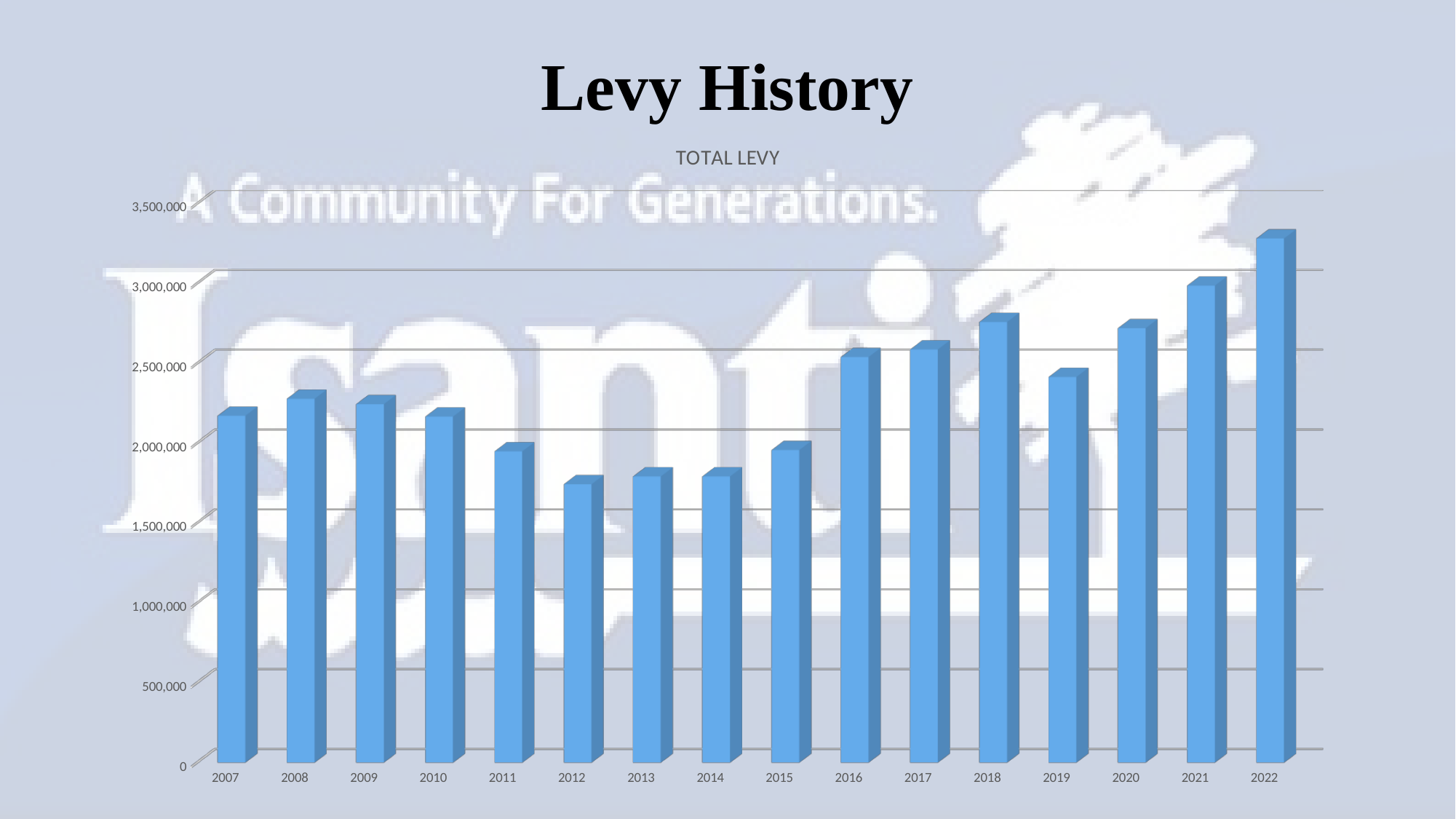
Is the total levy for 2007 greater or less than 2,000,000? greater Is the total levy for 2018 greater or less than 2,500,000? greater Which year has the larger total levy, 2008 or 2012? 2008 How many years are shown on the x axis of the chart? 16 Is the total levy for 2012 greater or less than 2,000,000? less What is the title shown above the chart's plot area? TOTAL LEVY Does the total levy generally rise or fall from 2012 to 2022? Rise What kind of chart is shown on the slide? Bar chart Which year has the highest total levy? 2022 Which year has the larger total levy, 2018 or 2019? 2018